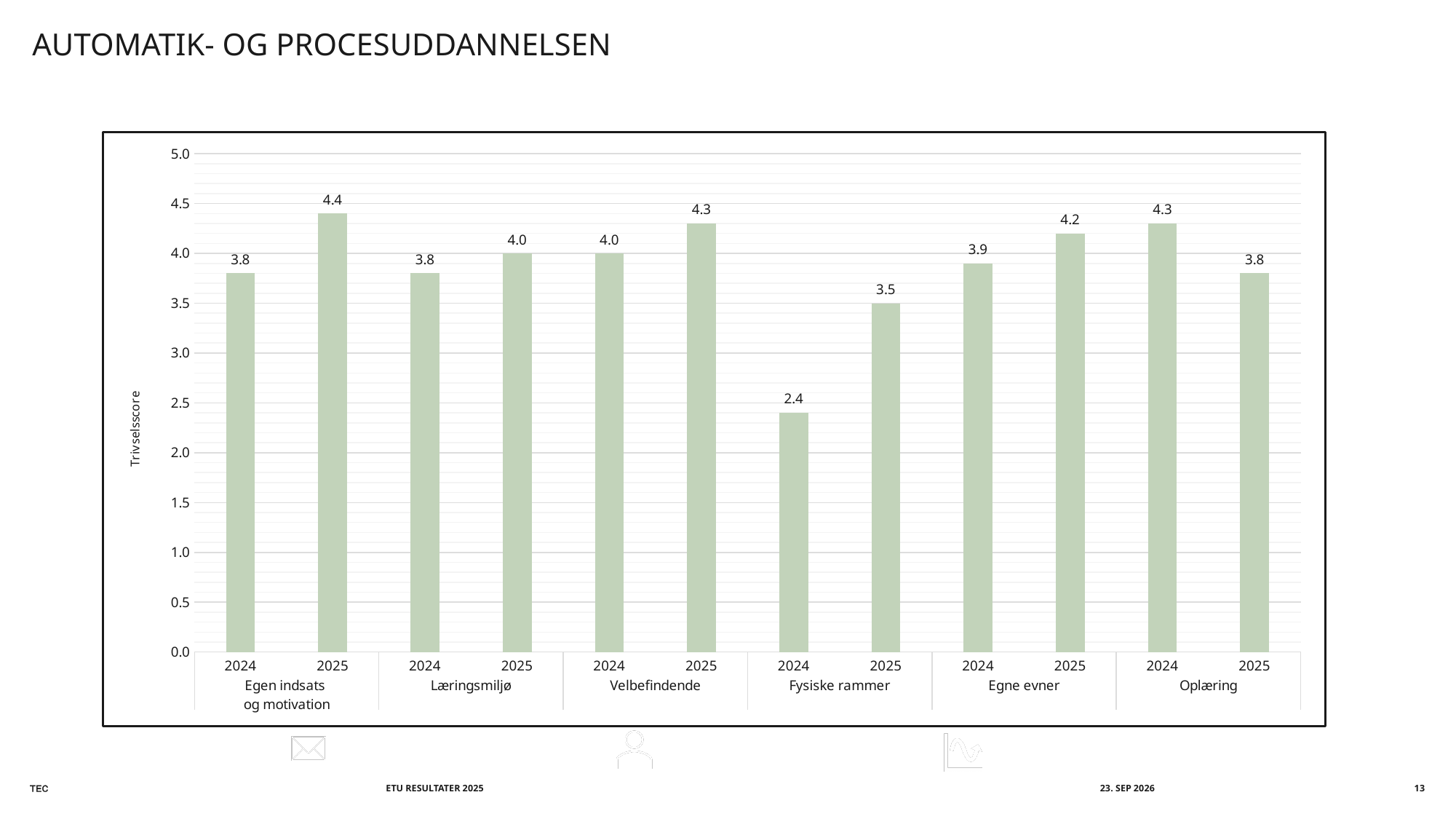
Which bar has the lowest value on the chart? Fysiske rammer 2024 What is the Trivselsscore for Oplæring in 2025? 3.8 How many bars are plotted on the chart? 12 What is the difference between the 2025 and 2024 values for Fysiske rammer? 1.1 What is the Trivselsscore for Fysiske rammer in 2024? 2.4 What kind of chart is shown on the slide? Bar chart Is the value for Egne evner in 2024 greater or less than 3.5? greater Which is larger, the 2024 value for Velbefindende or the 2025 value for Velbefindende? 2025 What is the label of the vertical axis? Trivselsscore What is the Trivselsscore for Egen indsats og motivation in 2025? 4.4 Which bar has the highest value on the chart? Egen indsats og motivation 2025 What is the difference between the 2024 and 2025 values for Oplæring? 0.5